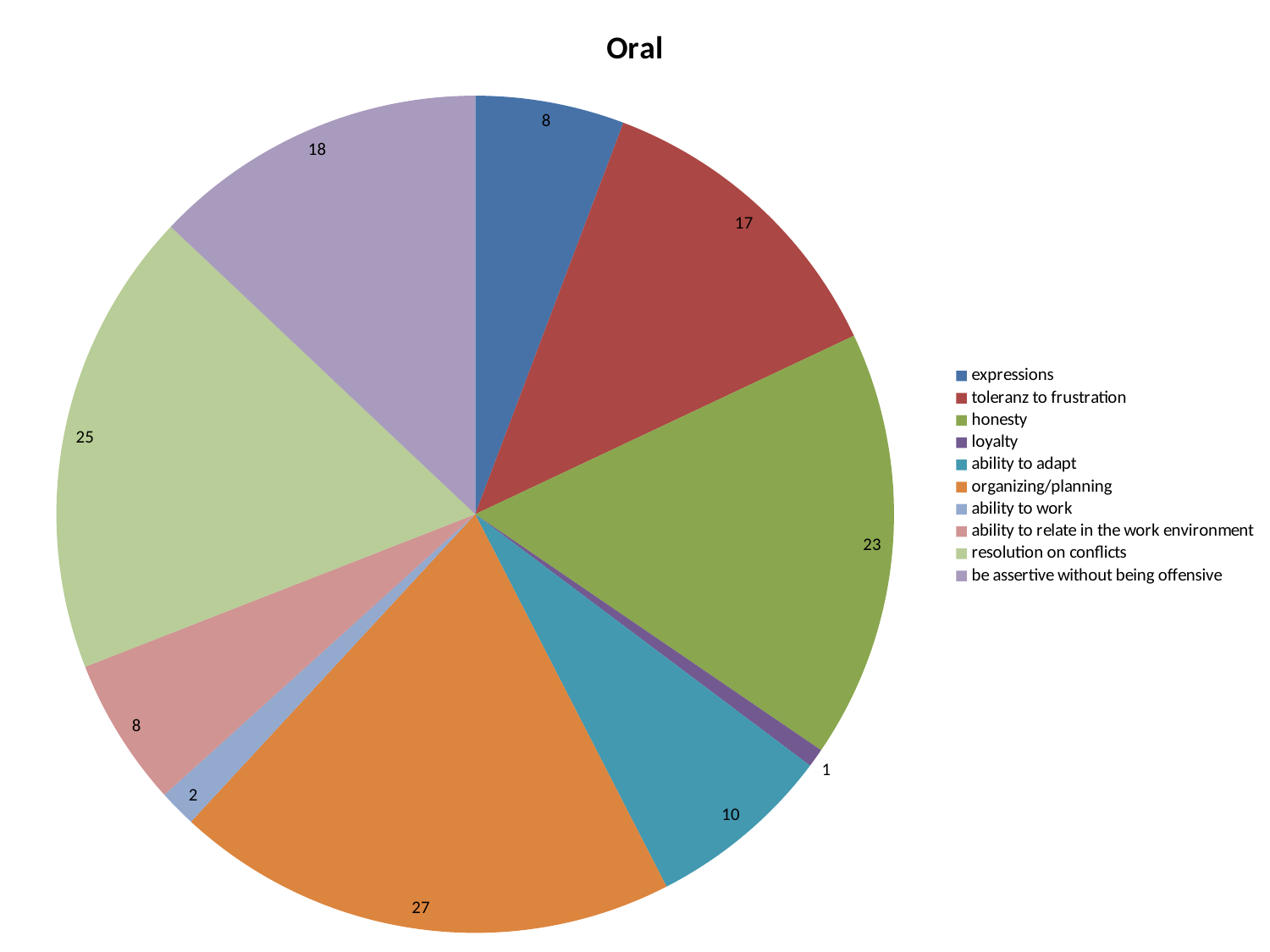
What is the total of all slices in the pie chart? 139 What is the value for loyalty? 1 What type of chart is shown on the slide? pie chart Which is larger, ability to adapt or ability to work? ability to adapt Which category has the smallest slice? loyalty What is the difference between resolution on conflicts and toleranz to frustration? 8 What is the value for honesty? 23 What is the value for be assertive without being offensive? 18 Which category has the largest slice? organizing/planning What is the value for organizing/planning? 27 How many categories does the pie chart have? 10 What is the title of the chart? Oral